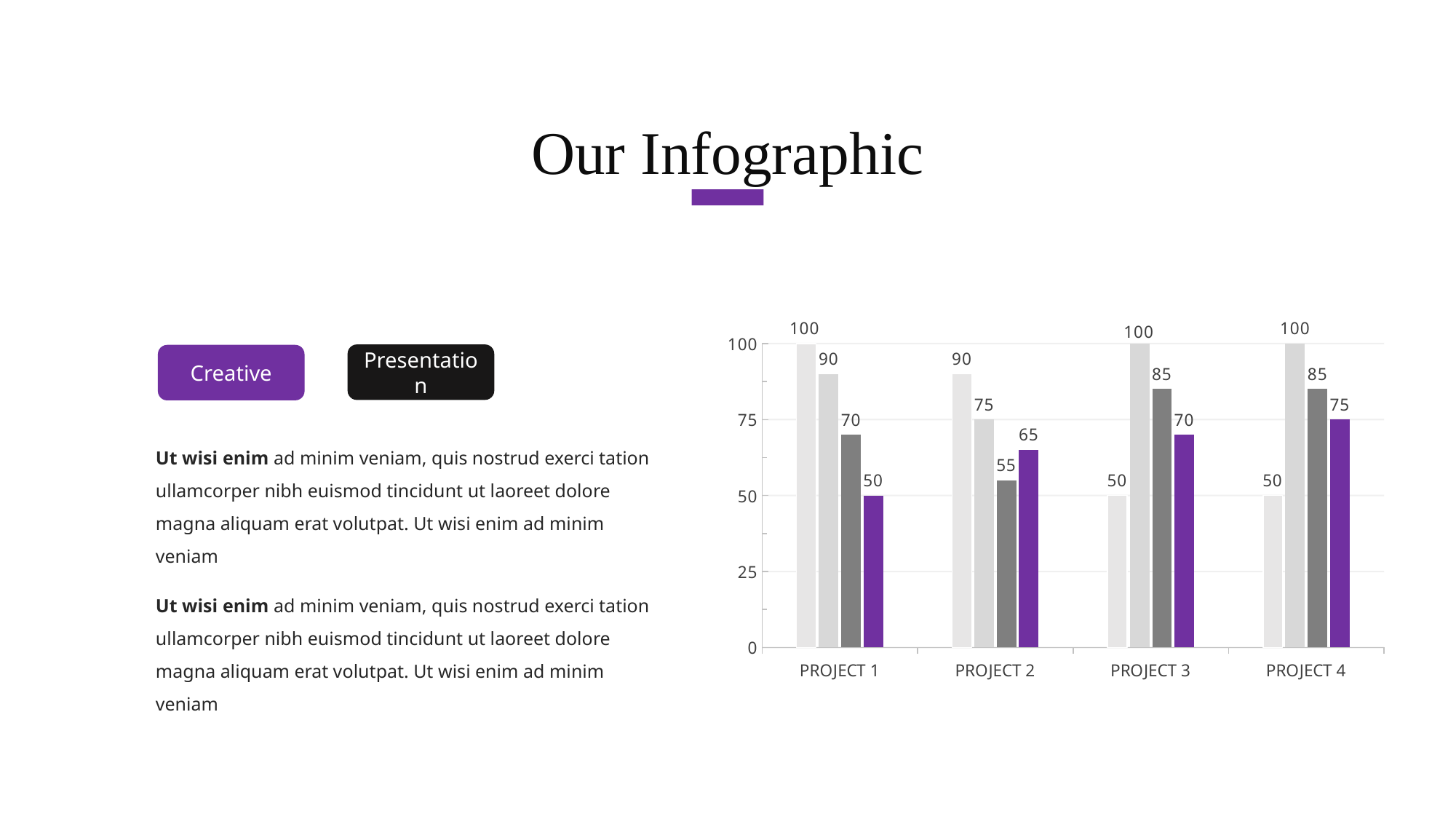
Which is larger: the dark grey bar for PROJECT 3 or the dark grey bar for PROJECT 2? PROJECT 3 What kind of chart is shown on the slide? Bar chart How many bars are plotted for each project? 4 Which project has the highest purple bar? PROJECT 4 What is the value of the purple bar for PROJECT 1? 50 Do the purple bars rise or fall from PROJECT 1 to PROJECT 4? Rise What is the value of the dark grey bar for PROJECT 1? 70 What is the value of the purple bar for PROJECT 4? 75 How many projects are shown on the x axis? 4 Which project has the lowest purple bar? PROJECT 1 What is the difference between the purple bar and the dark grey bar for PROJECT 2? 10 What is the value of the lightest grey bar for PROJECT 3? 50